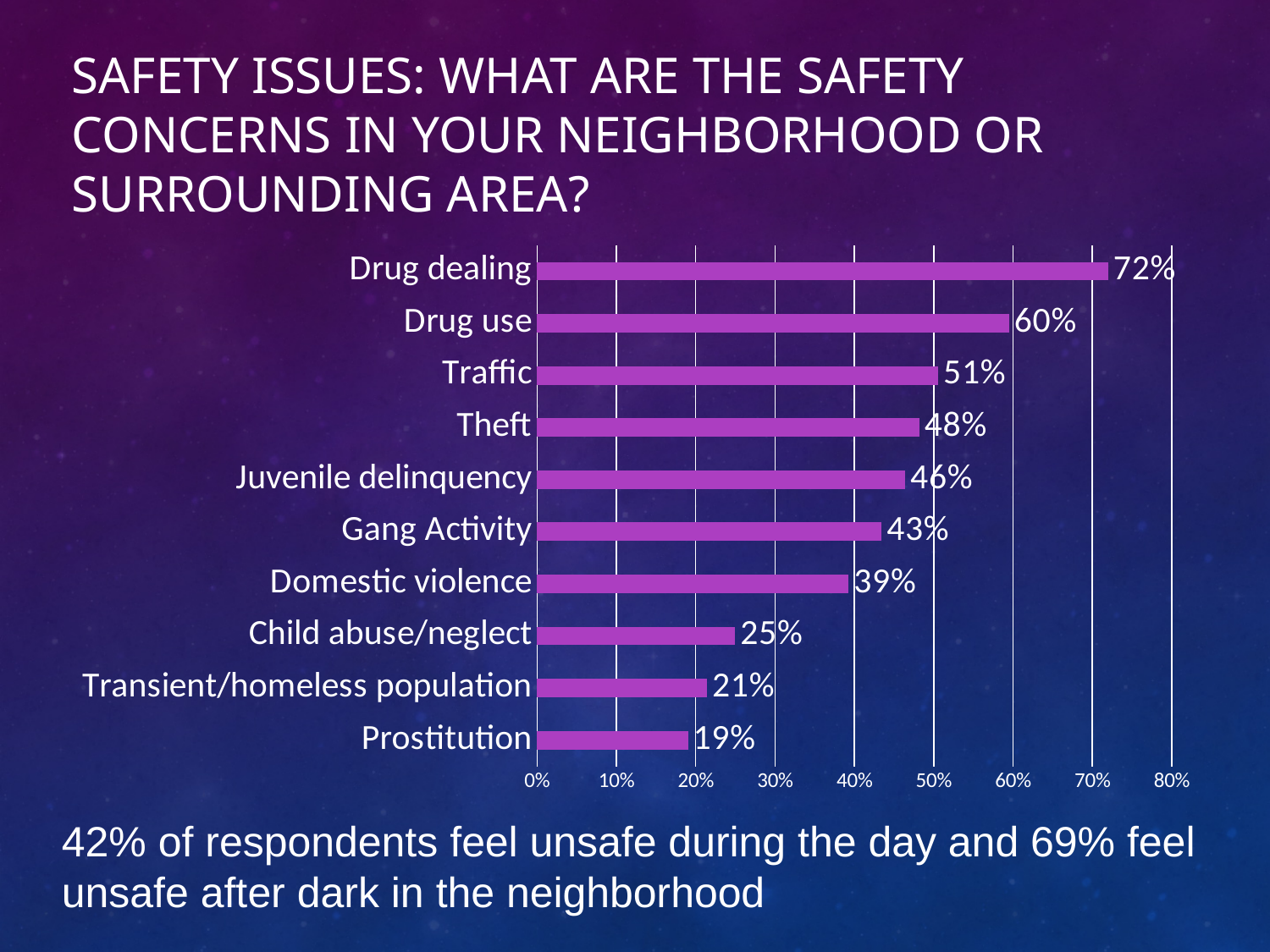
Is the value for Juvenile delinquency greater or less than 40%? greater Which has a higher percentage, Gang Activity or Domestic violence? Gang Activity What is the difference between the values for Theft and Child abuse/neglect? 23% What percentage of respondents cited Drug dealing as a safety concern? 72% What is the value shown for Traffic? 51% Which safety concern has the highest percentage? Drug dealing Which safety concern has the lowest percentage? Prostitution What is the highest value shown on the horizontal axis of the chart? 80% What is the difference between the percentages for Drug dealing and Drug use? 12% What percentage is shown for Transient/homeless population? 21% How many safety concerns are listed in the chart? 10 What kind of chart is shown on the slide? Bar chart